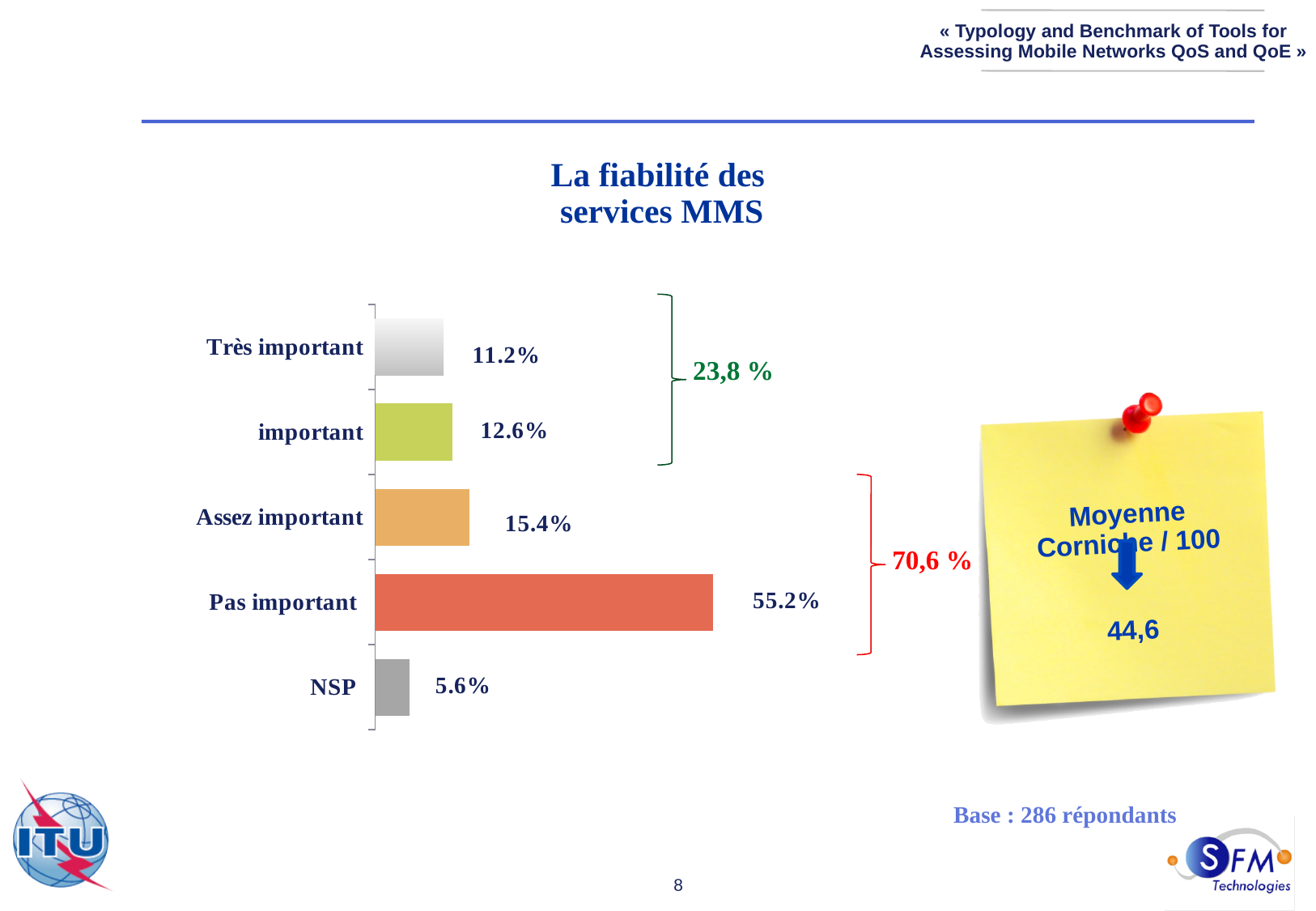
What is the value for "Assez important"? 15.4% What is the value for "Pas important"? 55.2% Which is larger, the value for "important" or the value for "Très important"? important How many categories are shown in the chart? 5 What is the value for "Très important"? 11.2% Which category has the lowest value? NSP What kind of chart is shown on the slide? Bar chart What is the combined percentage shown by the green bracket for "Très important" and "important"? 23,8 % Which category has the highest value? Pas important What is the value for "NSP"? 5.6% What is the difference between the values for "Pas important" and "Assez important"? 39.8% What is the title of the chart? La fiabilité des services MMS